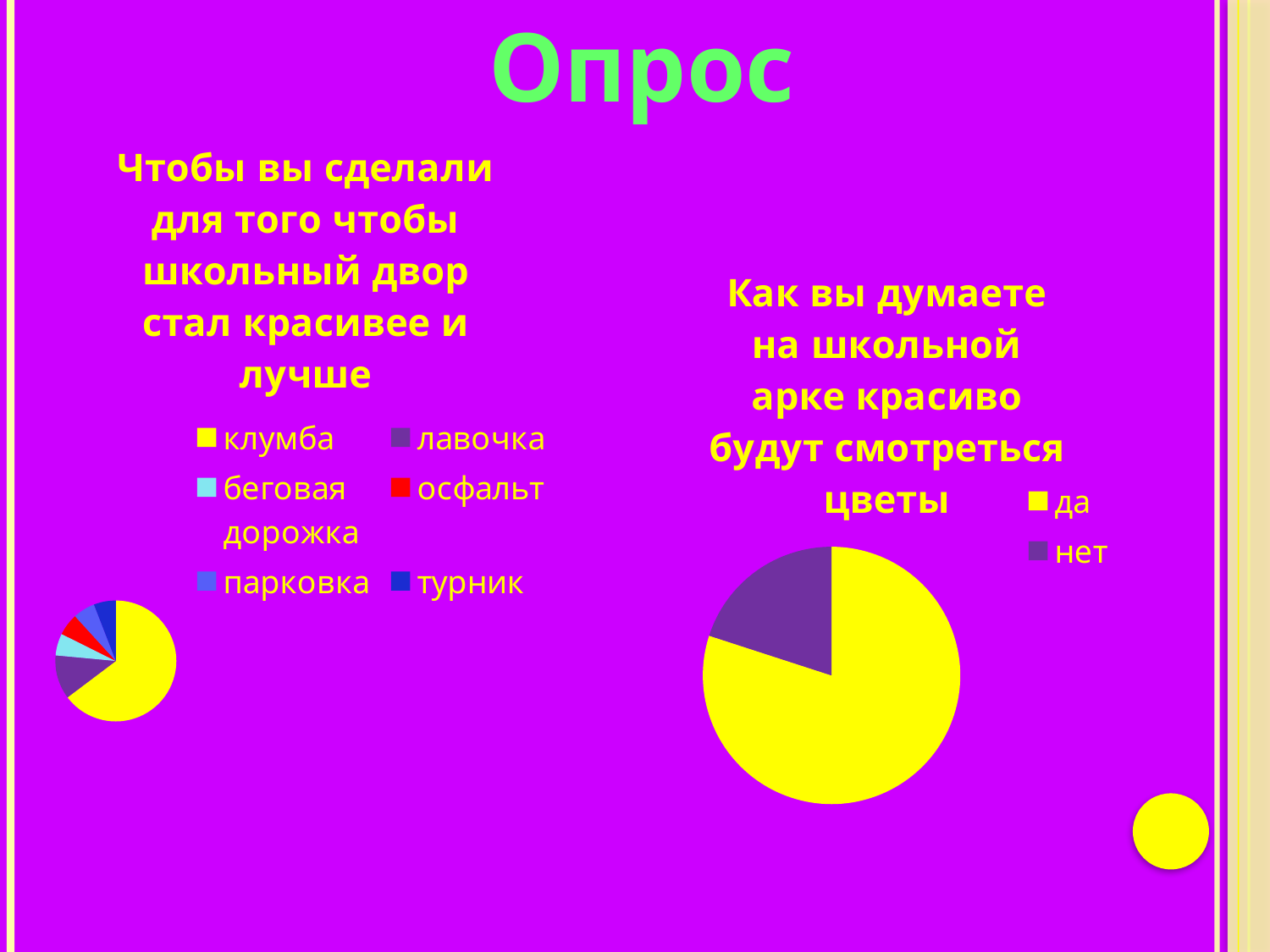
In the right chart, how many categories does the legend list? 2 In the right chart, what colour is the slice for "да"? yellow In the left chart, which slice is larger: лавочка or турник? лавочка What kind of chart is the right chart titled "Как вы думаете на школьной арке красиво будут смотреться цветы"? pie chart In the left chart, which category has the largest slice? клумба What kind of chart is the left chart titled "Чтобы вы сделали для того чтобы школьный двор стал красивее и лучше"? pie chart What is the title of the right chart? Как вы думаете на школьной арке красиво будут смотреться цветы In the right chart, which category has the smallest slice? нет In the right chart, which slice is larger: да or нет? да In the left chart, how many categories does the legend list? 6 In the right chart, which category has the largest slice? да In the left chart, which slice is larger: клумба or лавочка? клумба